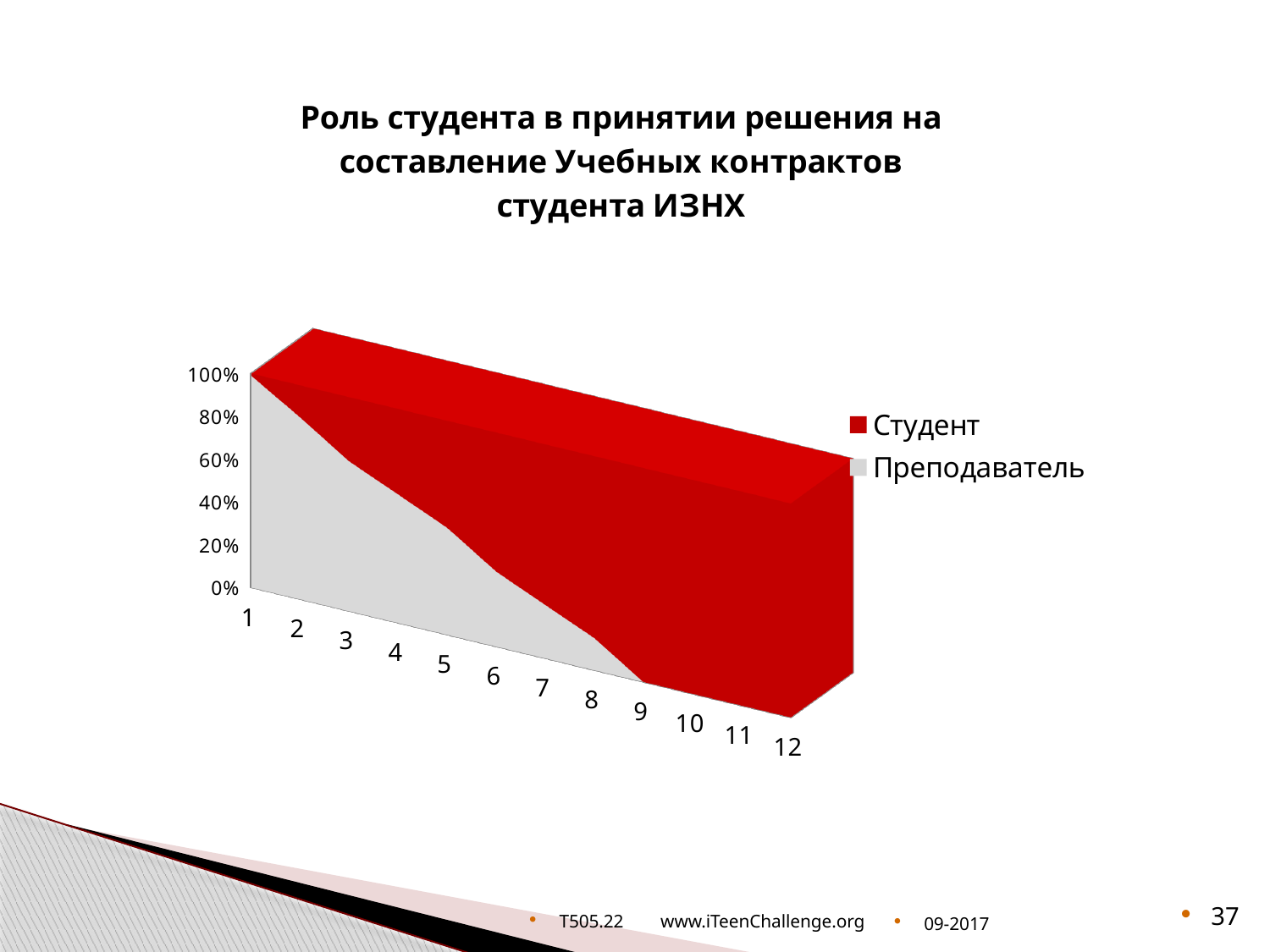
Does the value for Преподаватель rise or fall from category 1 to category 9? fall Is the value for Преподаватель at category 2 greater or less than 40%? greater Does the value for Студент rise or fall from category 1 to category 9? rise How many categories are shown along the x axis? 12 At category 1, which series has the larger value, Студент or Преподаватель? Преподаватель Which series is shown in red? Студент How many series does the legend list? 2 Is the value for Студент at category 11 greater or less than 60%? greater What kind of chart is shown on the slide? area chart Which series is shown in grey? Преподаватель Is the value for Преподаватель at category 5 greater or less than 60%? less